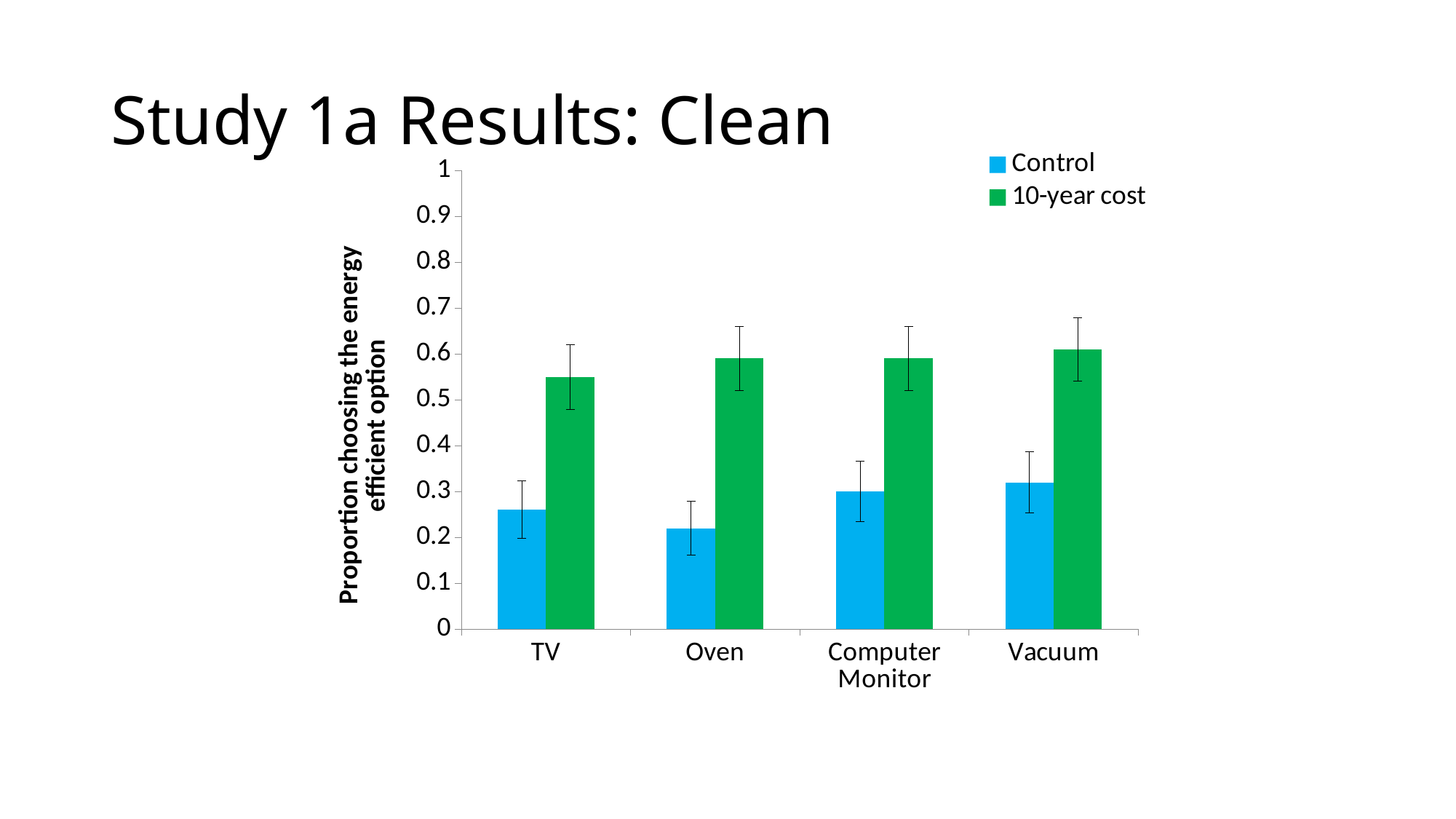
What kind of chart is shown on the slide? bar chart What is the label of the y axis? Proportion choosing the energy efficient option For Oven, which is larger: Control or 10-year cost? 10-year cost Is the 10-year cost value for Oven greater or less than 0.5? greater Which series is shown in green? 10-year cost Is the Control value for TV greater or less than 0.3? less For TV, which is larger: Control or 10-year cost? 10-year cost How many series does the legend list? 2 Which category has the lowest 10-year cost value? TV Which category has the lowest Control value? Oven Is the 10-year cost value for Computer Monitor greater or less than 0.7? less How many categories are shown on the x axis? 4